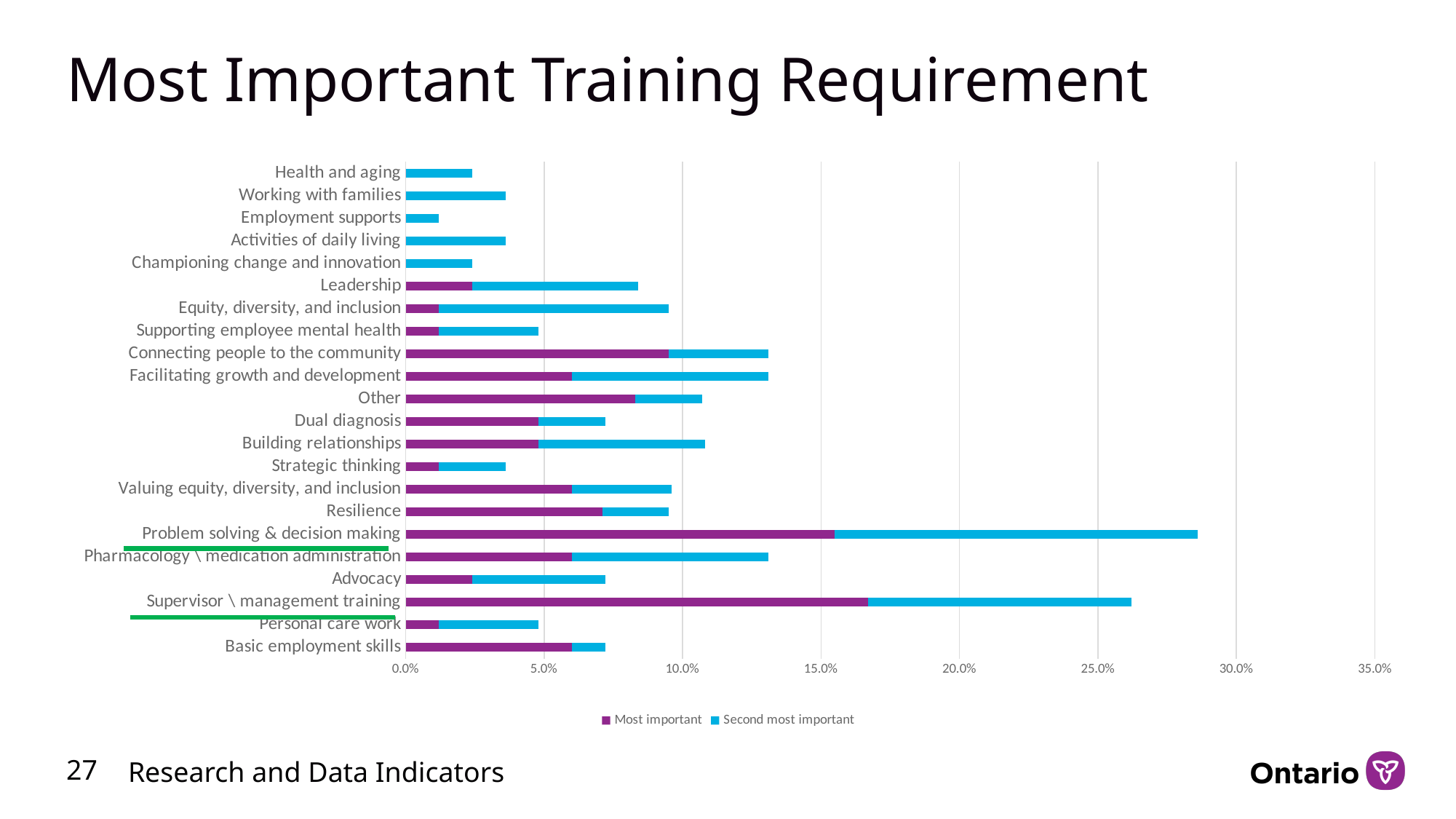
Which category has the shortest total bar? Employment supports What kind of chart is shown on the slide? Stacked bar chart Is the total bar for Leadership greater or less than 10.0%? less Which has the longer total bar, Supervisor \ management training or Pharmacology \ medication administration? Supervisor \ management training Is the total bar for Connecting people to the community greater or less than 10.0%? greater Which category has the longest total bar? Problem solving & decision making How many series does the legend list? 2 How many training requirement categories are plotted? 22 What are the two series named in the legend? Most important; Second most important Which has the longer total bar, Other or Dual diagnosis? Other Which category has the largest 'Most important' segment? Supervisor \ management training Is the total bar for Problem solving & decision making greater or less than 25.0%? greater